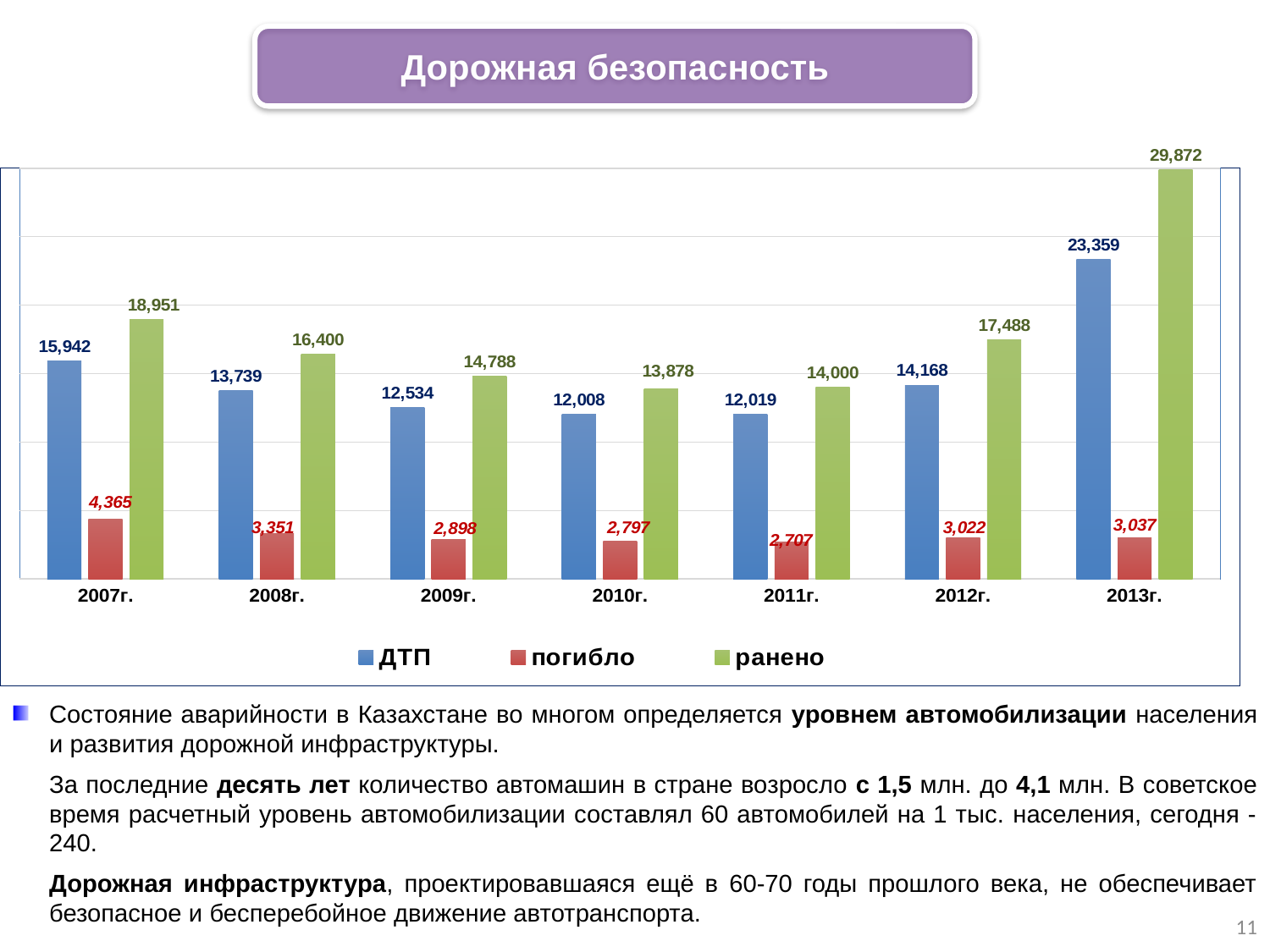
What is the difference between the ранено values for 2013г. and 2012г.? 12,384 What kind of chart is shown on the slide? bar chart Which is larger, the ДТП value for 2008г. or the ДТП value for 2012г.? 2012г. In which year is the погибло value lowest? 2011г. What is the value for ранено in 2010г.? 13,878 How many years are shown on the x axis? 7 What is the title shown above the chart? Дорожная безопасность What is the value for ДТП in 2013г.? 23,359 In which year is the ранено value highest? 2013г. How many series does the legend list? 3 What is the difference between the ДТП values for 2013г. and 2007г.? 7,417 What is the value for погибло in 2007г.? 4,365